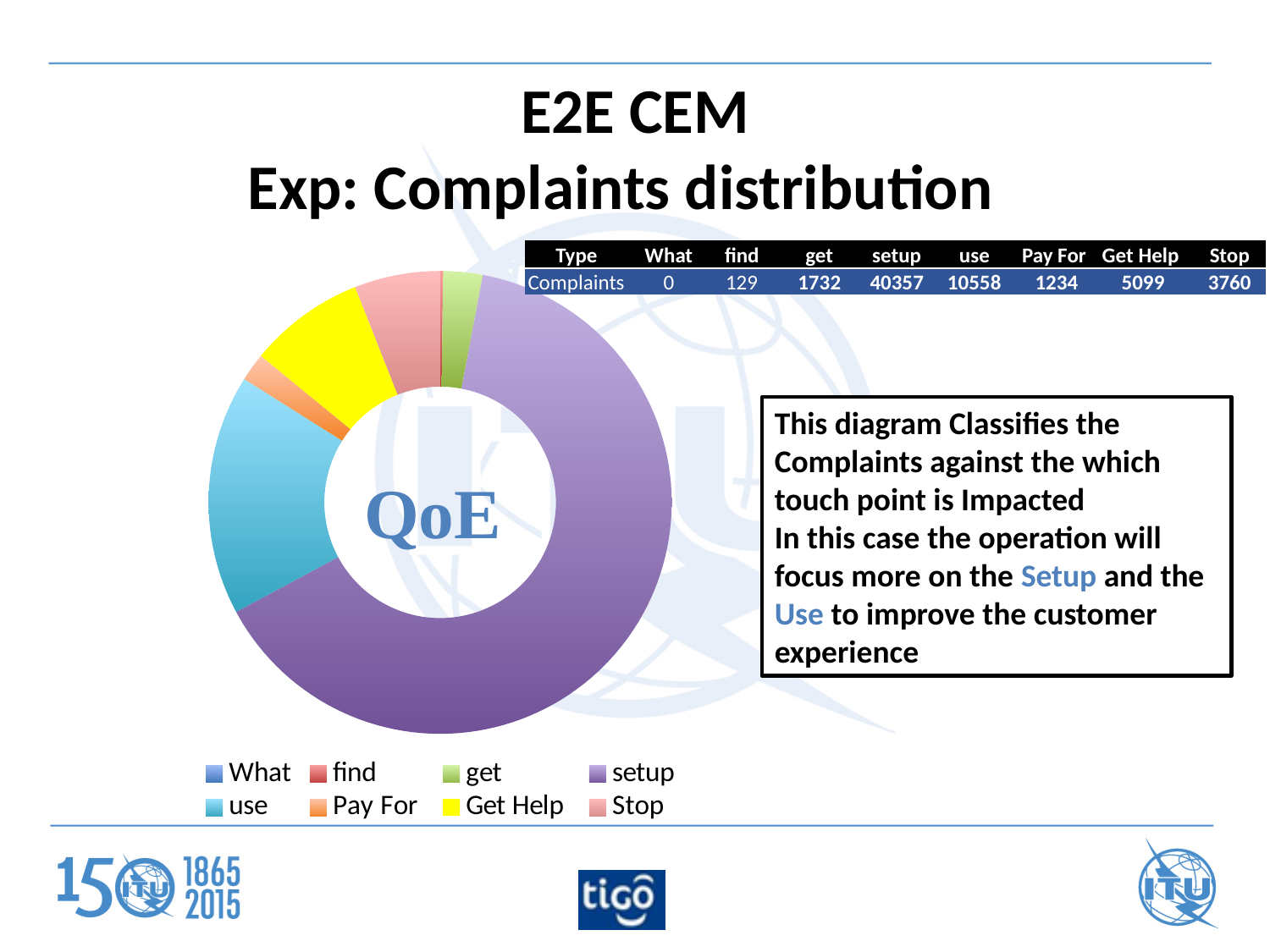
What is the difference in complaints between setup and use? 29799 Which touch point has the lowest number of complaints? What How many complaints are recorded for the use touch point? 10558 How many complaints are recorded for the setup touch point? 40357 How many complaints are recorded for Get Help? 5099 What is the difference in complaints between Get Help and Stop? 1339 How many complaints are recorded for Stop? 3760 How many touch point categories does the chart show? 8 What text is displayed in the centre of the doughnut chart? QoE Which has more complaints, Pay For or get? get Which touch point has the highest number of complaints? setup What kind of chart is shown on the slide? Doughnut chart